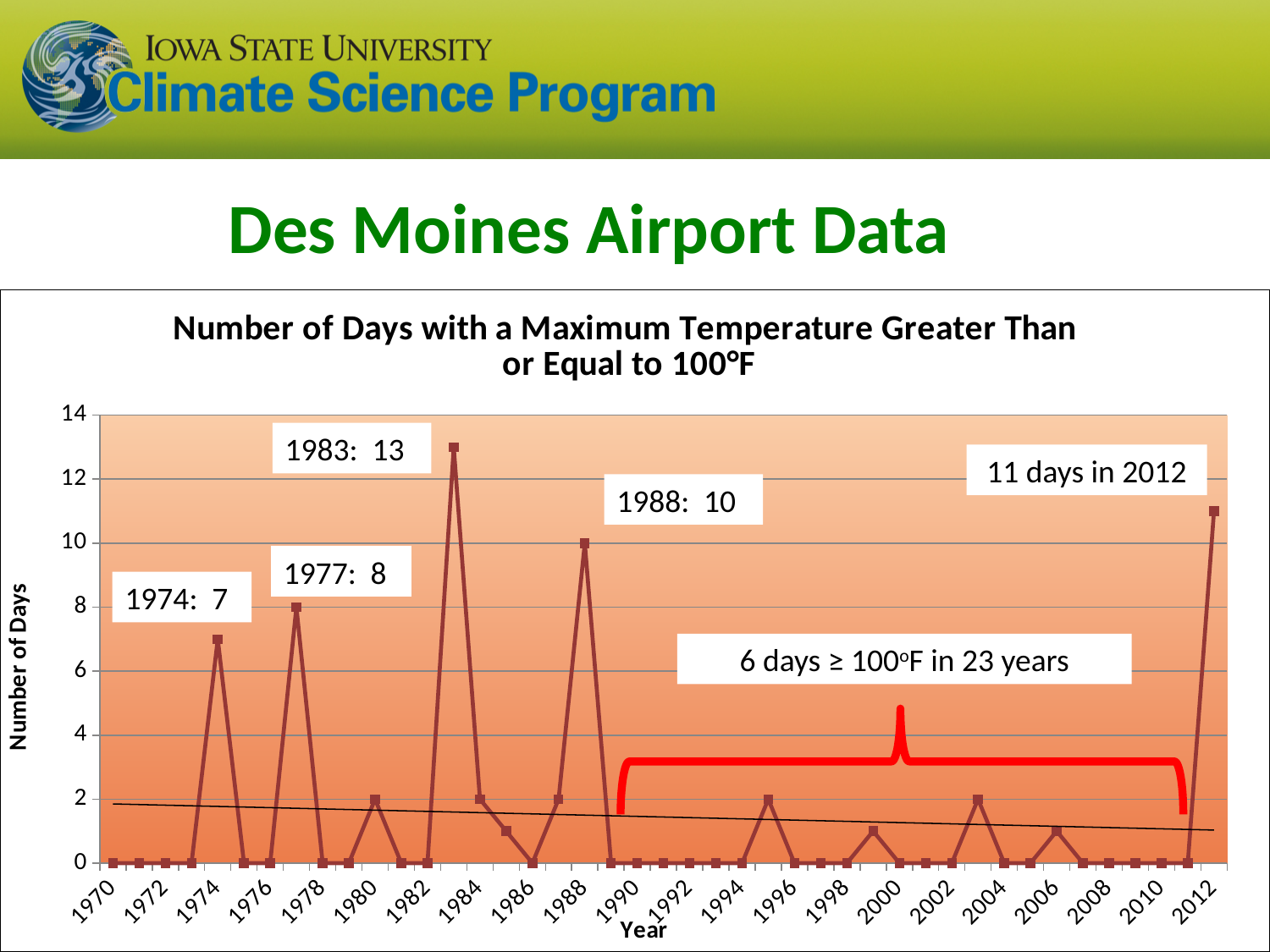
Is the value for 1983 greater or less than 12? greater What is the difference between the number of days in 1983 and the number of days in 1988? 3 How many days with a maximum temperature of at least 100°F were recorded in 1988? 10 Which year had more days with a maximum temperature of at least 100°F, 1974 or 1977? 1977 How many days with a maximum temperature of at least 100°F were recorded in 1983? 13 How many days with a maximum temperature of at least 100°F were recorded in 1974? 7 Does the black trend line drawn across the chart rise or fall from 1970 to 2012? fall Which year has the highest number of days with a maximum temperature of at least 100°F? 1983 What kind of chart is shown on the slide? line chart How many days with a maximum temperature of at least 100°F were recorded in 2012? 11 What is the label of the vertical axis? Number of Days What is the title of the chart? Number of Days with a Maximum Temperature Greater Than or Equal to 100°F